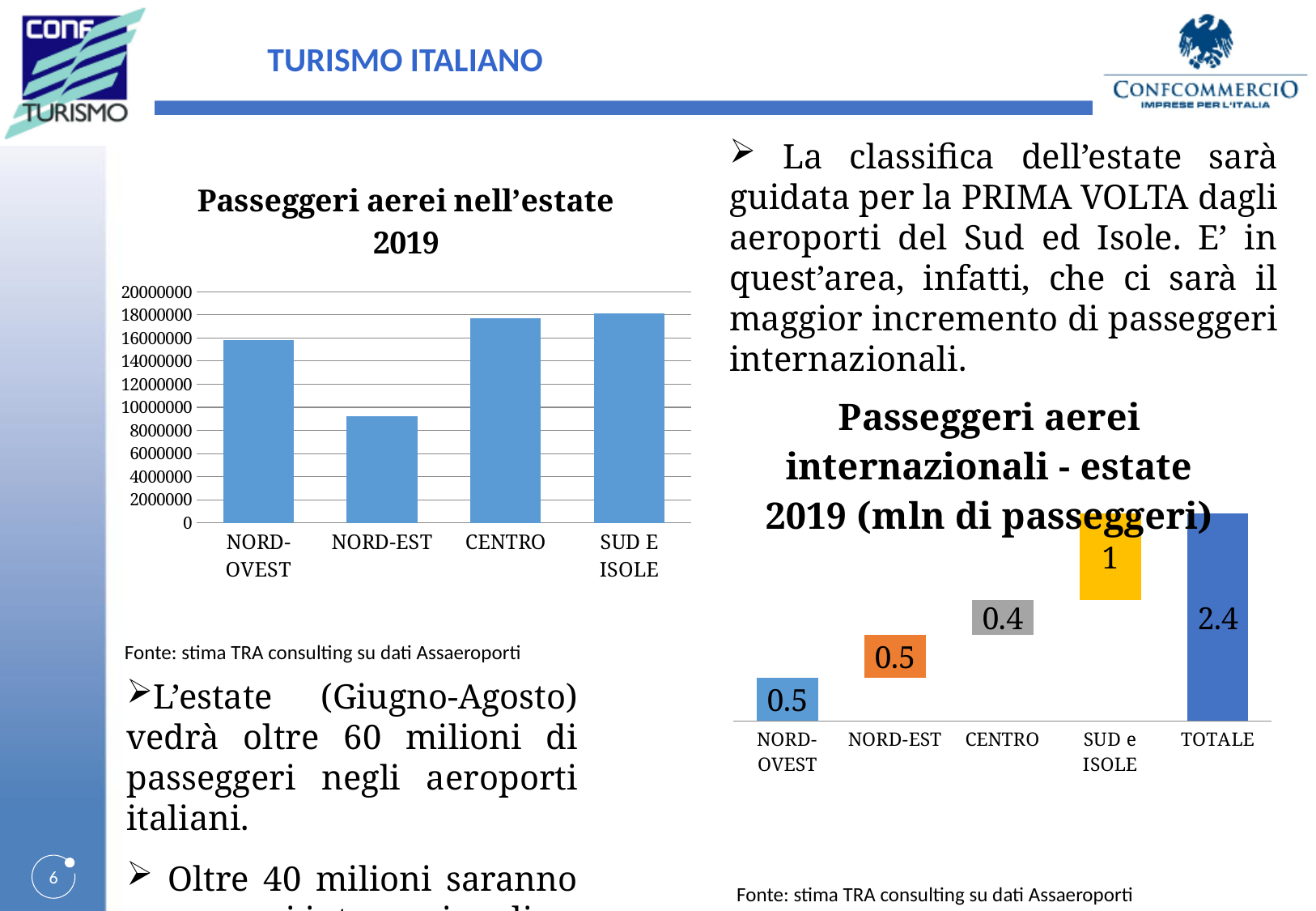
How many categories are shown in the chart 'Passeggeri aerei nell'estate 2019'? 4 In the chart 'Passeggeri aerei internazionali - estate 2019', what is the value for TOTALE? 2.4 What kind of chart is 'Passeggeri aerei nell'estate 2019'? bar chart How many categories are shown on the x axis of the chart 'Passeggeri aerei internazionali - estate 2019'? 5 In the chart 'Passeggeri aerei nell'estate 2019', is the value for NORD-OVEST greater or less than 14000000? greater In the chart 'Passeggeri aerei internazionali - estate 2019', what is the value for SUD e ISOLE? 1 In the chart 'Passeggeri aerei nell'estate 2019', is the value for CENTRO greater or less than 16000000? greater In the chart 'Passeggeri aerei internazionali - estate 2019', what is the difference between the values for SUD e ISOLE and CENTRO? 0.6 In the chart 'Passeggeri aerei nell'estate 2019', which category has the lowest value? NORD-EST In the chart 'Passeggeri aerei nell'estate 2019', is the value for NORD-EST greater or less than 10000000? less In the chart 'Passeggeri aerei nell'estate 2019', which is larger, the value for NORD-OVEST or the value for NORD-EST? NORD-OVEST In the chart 'Passeggeri aerei internazionali - estate 2019', which region has the lowest value? CENTRO